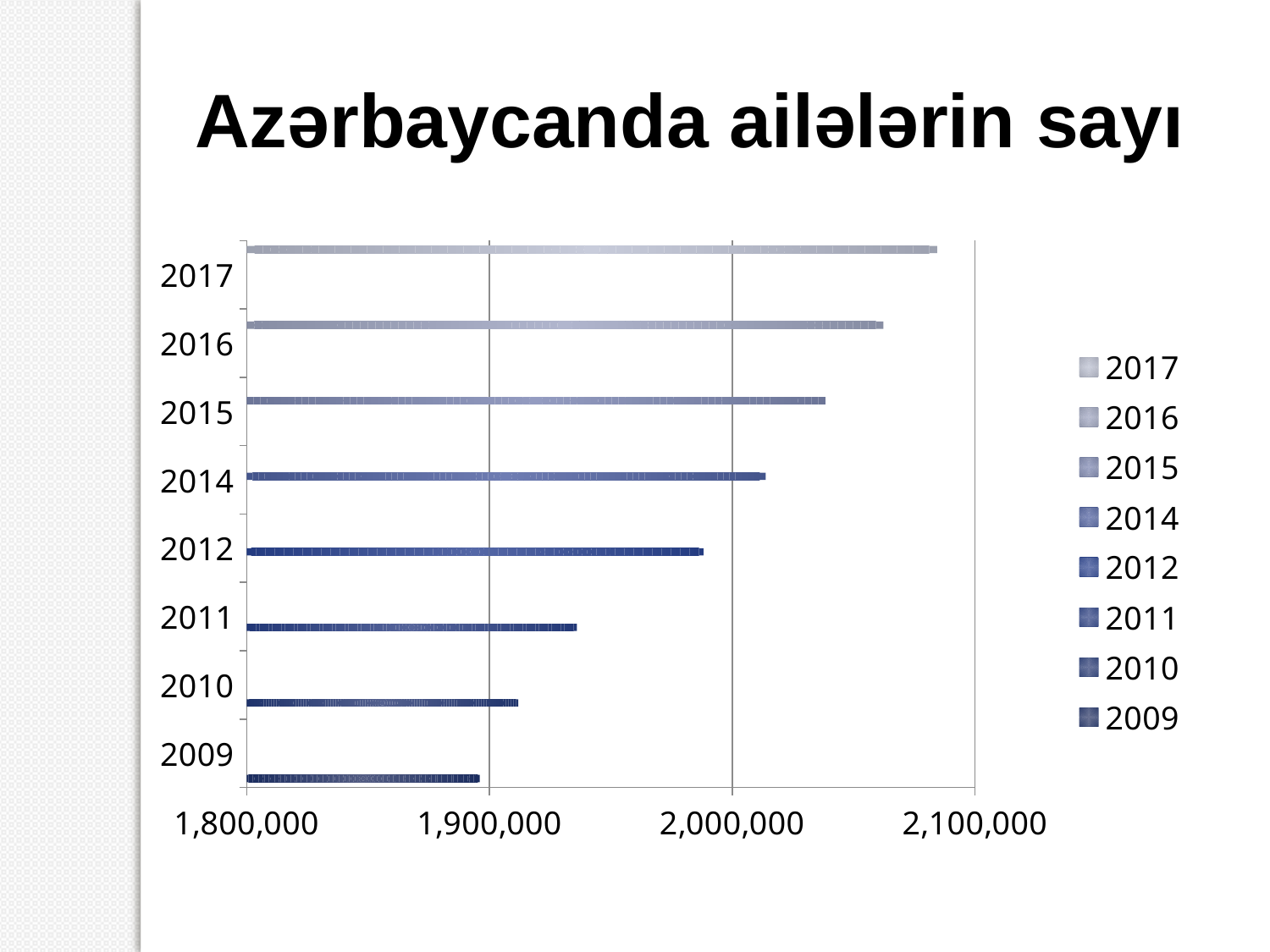
How many years (categories) are plotted in the chart? 8 Which year has the lowest number of families? 2009 What is the title of the chart? Azərbaycanda ailələrin sayı Is the value for 2011 greater or less than 1,900,000? greater Which year has the highest number of families? 2017 Do the values rise or fall from 2009 to 2017? rise Is the value for 2012 greater or less than 2,000,000? less What kind of chart is shown on the slide? bar chart How many entries does the legend list? 8 Is the value for 2017 greater or less than 2,100,000? less Which is larger, the value for 2014 or the value for 2011? 2014